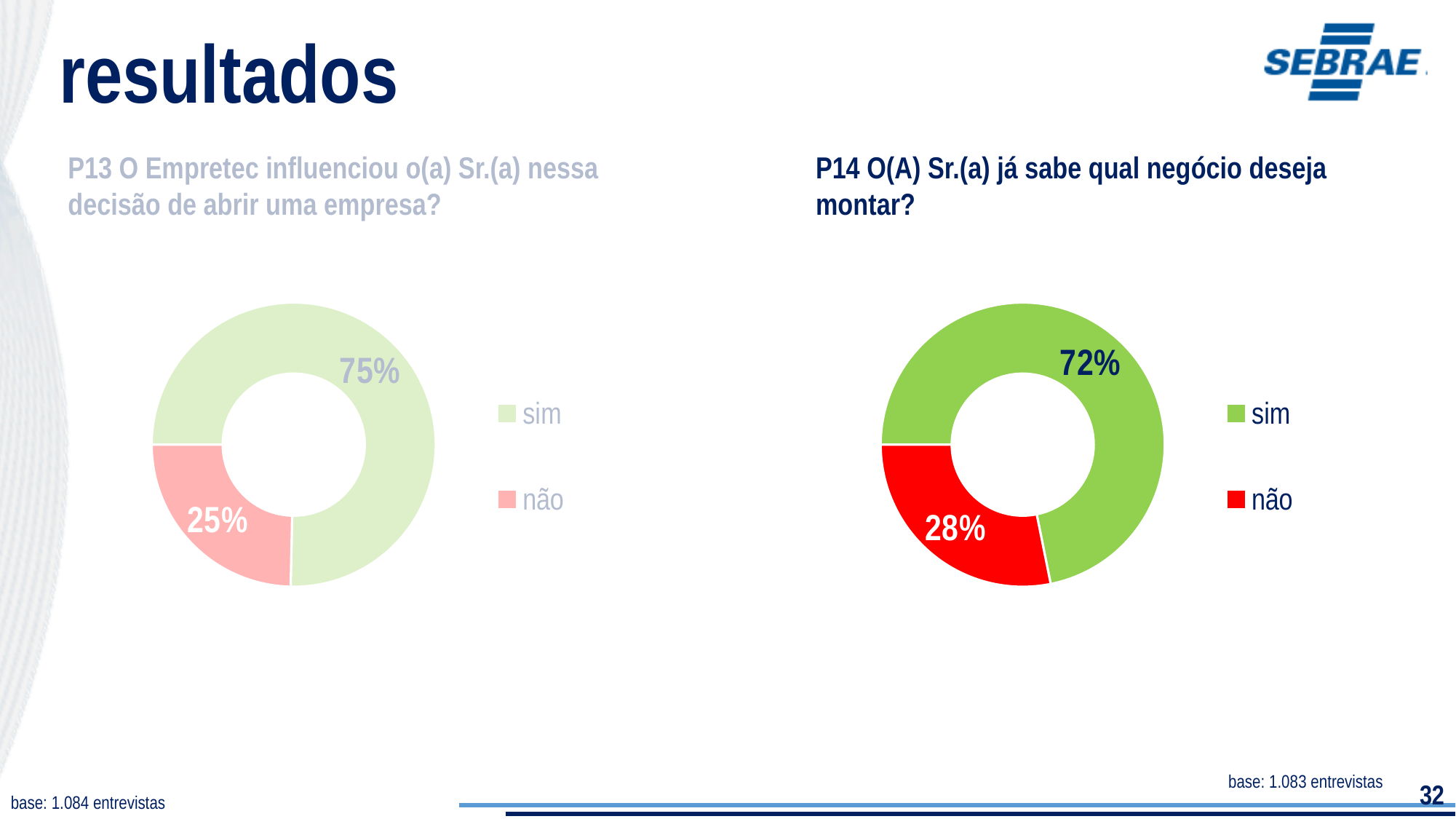
How many categories does the P14 chart (right) show? 2 What type of chart is used for P14 (right)? Pie chart (doughnut) In the P14 chart (right), what percentage answered 'não'? 28% In the P13 chart (left), what percentage answered 'sim'? 75% In the P13 chart (left), what percentage answered 'não'? 25% In the P14 chart (right), what colour represents 'não'? Red In the P13 chart (left), which category has the smallest share? não In the P14 chart (right), what percentage answered 'sim'? 72% In the P13 chart (left), what is the difference between the 'sim' and 'não' shares? 50% In the P14 chart (right), which category has the largest share? sim In the P14 chart (right), what is the difference between the 'sim' and 'não' shares? 44% Which is larger: the 'sim' share in the P13 chart (left) or the 'sim' share in the P14 chart (right)? P13 (75%)